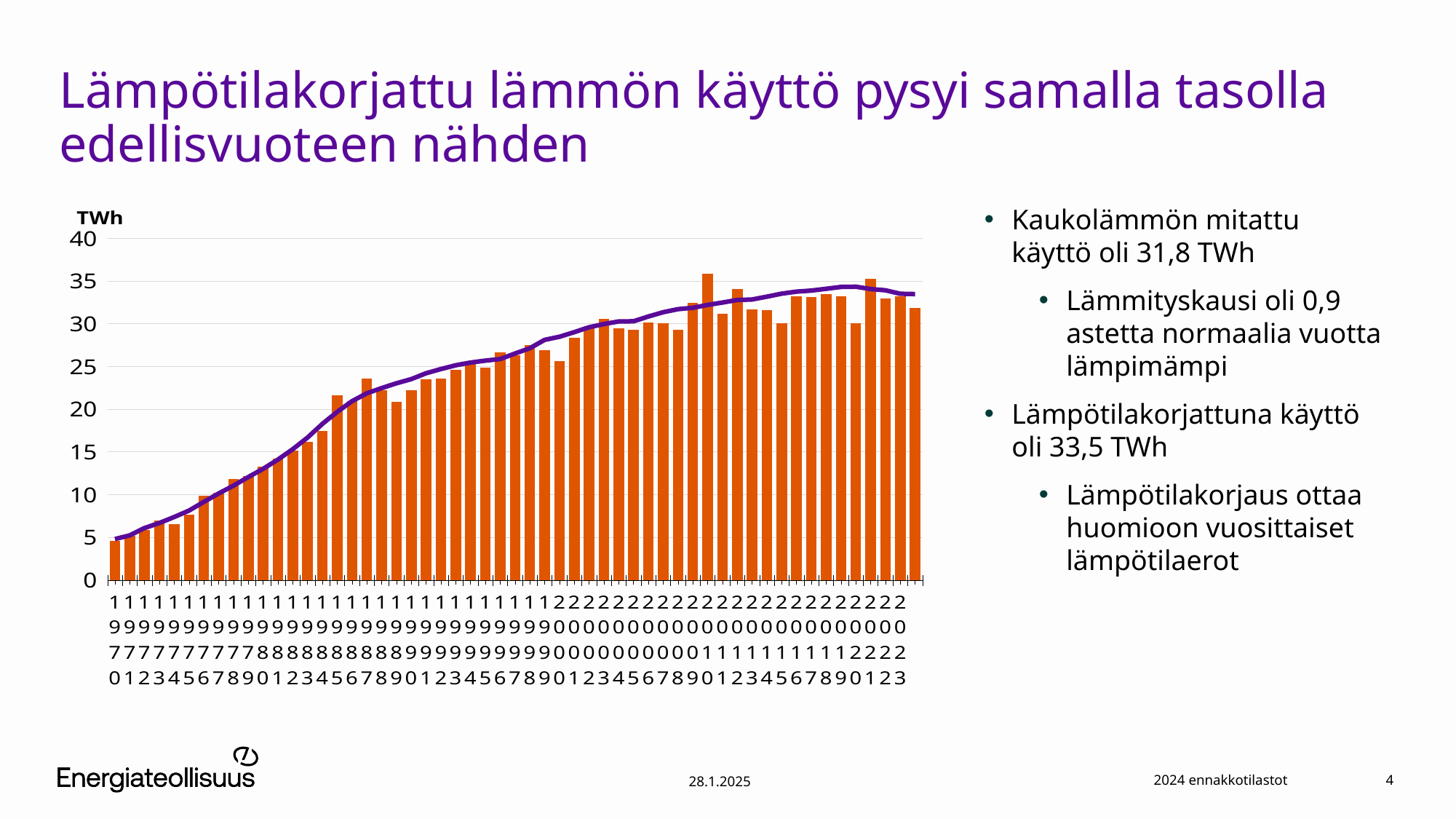
Is the bar value for 1990 greater or less than 20? greater What is the first year shown on the x axis of the chart? 1970 How many years (bars) are plotted on the chart? 55 Is the bar value for 1970 greater or less than 5? less Is the bar value for 1980 greater or less than 15? less What unit is shown on the y axis of the chart? TWh Which year has the lowest bar on the chart? 1970 Which year has the larger bar, 2010 or 2011? 2010 Which year has the highest bar on the chart? 2010 What kind of chart is shown on the slide? Bar chart with a line Do the bar values generally rise or fall from 1970 to 2023? rise